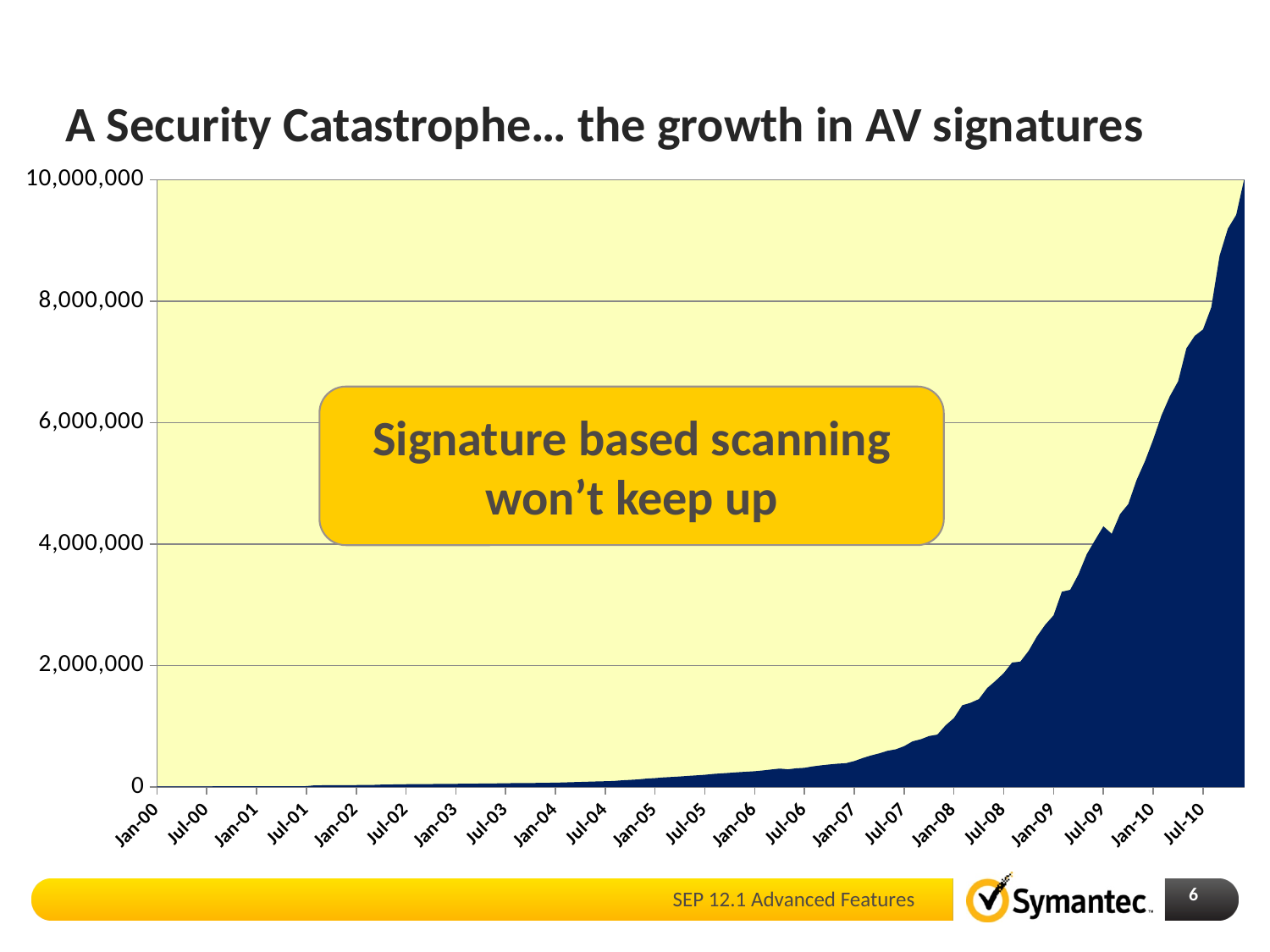
Which is larger, the value for Jan-05 or the value for Jan-10? Jan-10 Is the value for Jul-10 greater or less than 6,000,000? greater Is the value for Jan-08 greater or less than 2,000,000? less Is the value for Jan-09 greater or less than 2,000,000? greater What kind of chart is shown on the slide? area chart Do the values rise or fall over time along the x axis? rise Which labelled date on the x axis has the lowest value? Jan-00 How many date labels are shown on the x axis? 22 What is the highest value shown on the y axis? 10,000,000 What is the title of the slide's chart? A Security Catastrophe… the growth in AV signatures